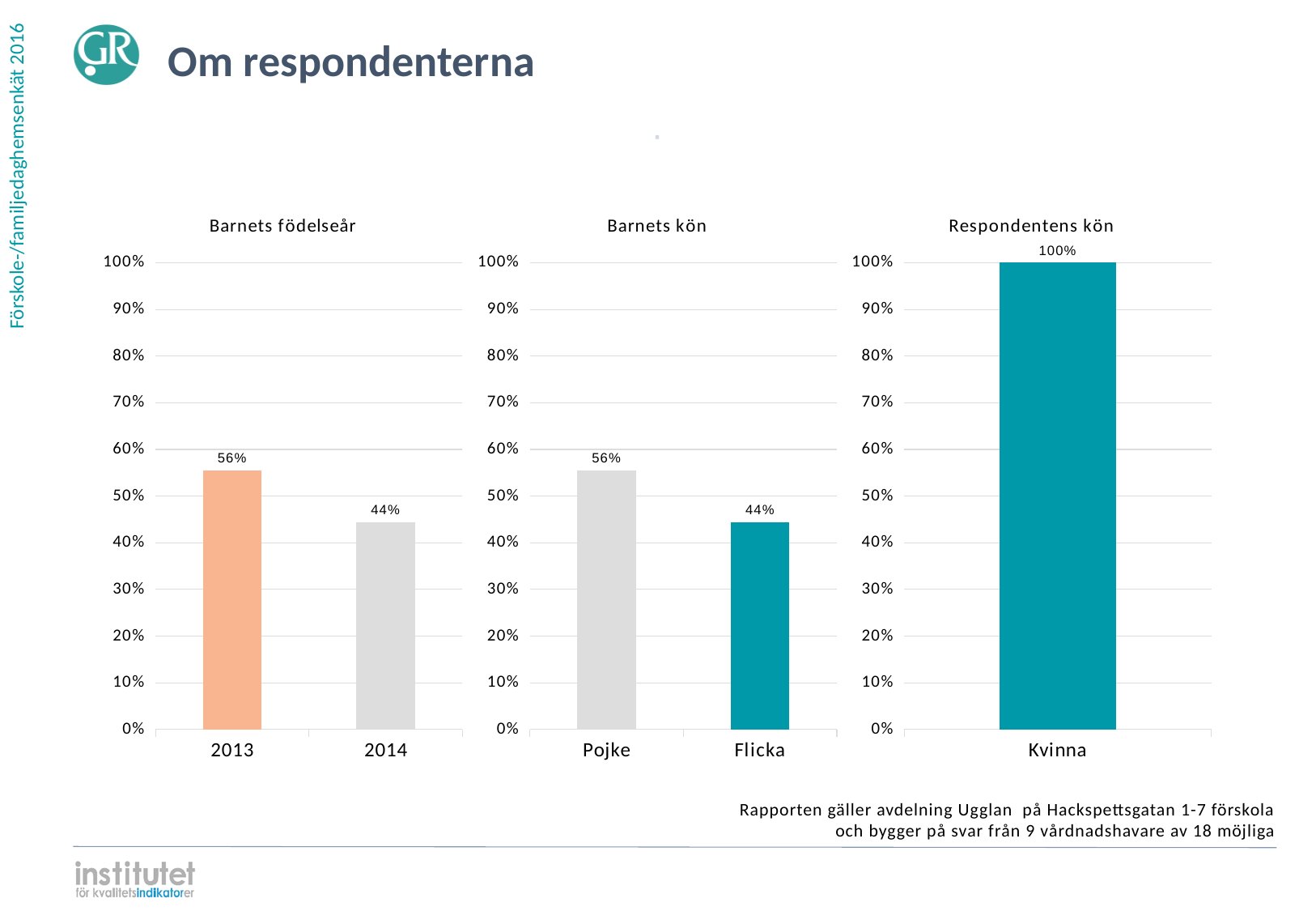
In the 'Barnets kön' chart, which is larger, the value for Pojke or the value for Flicka? Pojke In the 'Barnets födelseår' chart, which category has the highest value? 2013 In the 'Barnets födelseår' chart, is the value for 2014 greater or less than 50%? less In the 'Barnets födelseår' chart, what is the difference between the values for 2013 and 2014? 12% In the 'Barnets kön' chart, what is the value for Flicka? 44% In the 'Barnets födelseår' chart, what is the value for 2013? 56% How many categories are shown in the 'Respondentens kön' chart? 1 In the 'Barnets kön' chart, which category has the lowest value? Flicka In the 'Barnets kön' chart, what is the value for Pojke? 56% What kind of chart is the 'Barnets kön' chart? Bar chart In the 'Respondentens kön' chart, what is the value for Kvinna? 100% In the 'Barnets födelseår' chart, what is the value for 2014? 44%